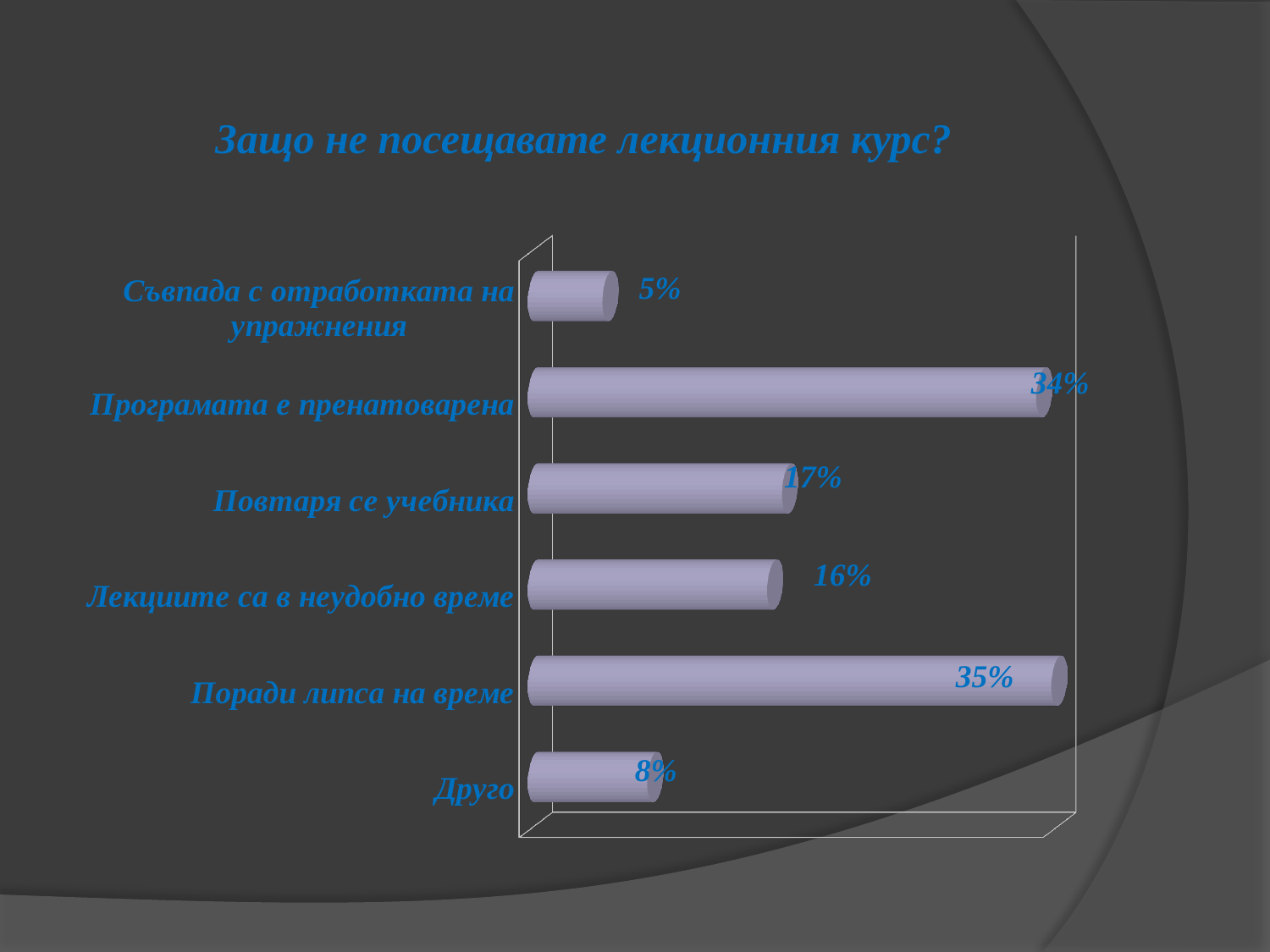
What is the value for "Програмата е пренатоварена"? 34% What is the value for "Лекциите са в неудобно време"? 16% What kind of chart is shown on the slide? bar chart What is the title of the chart? Защо не посещавате лекционния курс? Which category has the highest value? Поради липса на време What is the difference between the values for "Поради липса на време" and "Съвпада с отработката на упражнения"? 30% Which category has the lowest value? Съвпада с отработката на упражнения What is the value for "Повтаря се учебника"? 17% Which is larger, the value for "Друго" or the value for "Съвпада с отработката на упражнения"? Друго How many categories does the chart show? 6 What is the value for "Друго"? 8% What is the value for "Поради липса на време"? 35%